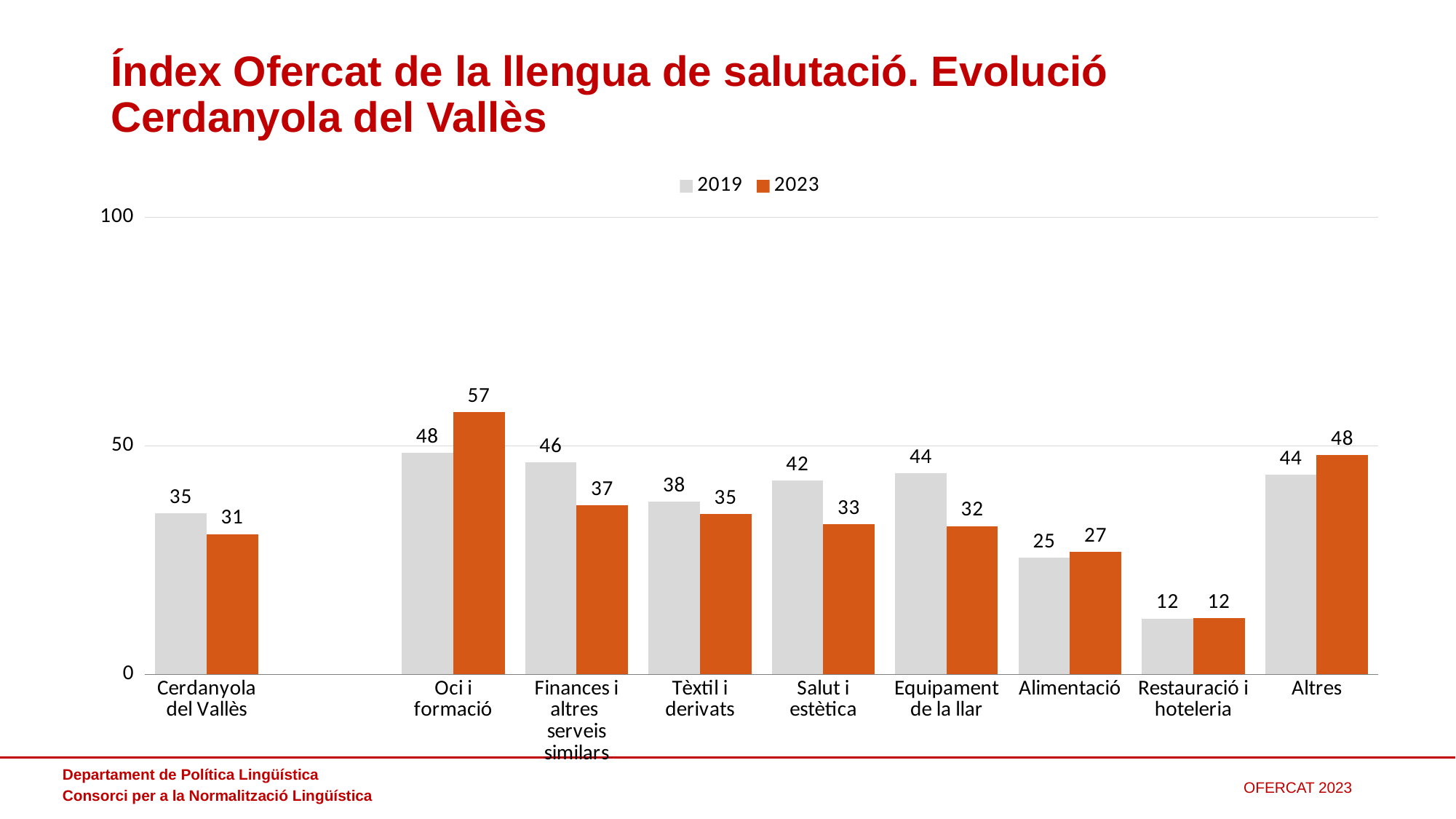
What kind of chart is shown on the slide? bar chart What is the 2023 value for Oci i formació? 57 What is the 2023 value for Cerdanyola del Vallès? 31 Which is larger for Alimentació, the 2019 value or the 2023 value? 2023 Which colour represents the 2023 series in the legend? orange What is the 2019 value for Equipament de la llar? 44 What is the difference between the 2019 and 2023 values for Equipament de la llar? 12 Which category has the highest 2023 value? Oci i formació How many categories are shown on the x axis? 9 Is the 2023 value for Finances i altres serveis similars greater or less than 50? less How many series does the legend list? 2 Which category has the lowest 2019 value? Restauració i hoteleria